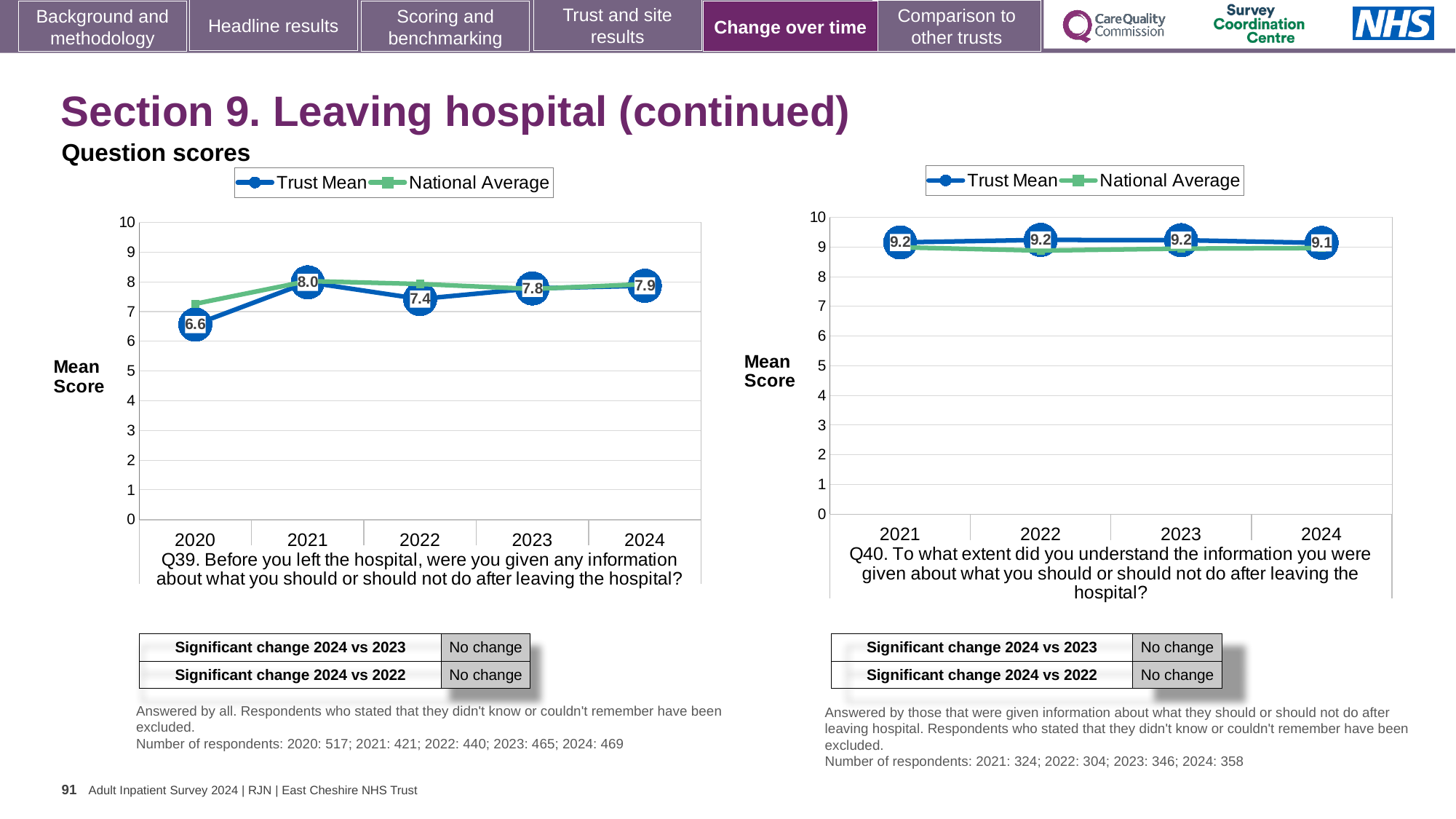
In the Q39 chart (left), what is the difference between the Trust Mean scores for 2021 and 2020? 1.4 In the Q39 chart (left), which year has the lowest Trust Mean score? 2020 In the Q39 chart (left), what is the Trust Mean score for 2020? 6.6 In the Q40 chart (right), what is the Trust Mean score for 2024? 9.1 In the Q39 chart (left), is the National Average for 2020 greater or less than 7? greater What type of chart is used for the Q40 chart (right)? Line chart In the Q39 chart (left), how many years are plotted on the x axis? 5 In the Q39 chart (left), which year has the highest Trust Mean score? 2021 In the Q39 chart (left), what is the Trust Mean score for 2022? 7.4 In the Q40 chart (right), how many series does the legend list? 2 In the Q40 chart (right), is the National Average for 2022 greater or less than 8? greater In the Q39 chart (left), is the Trust Mean score for 2023 or 2022 larger? 2023